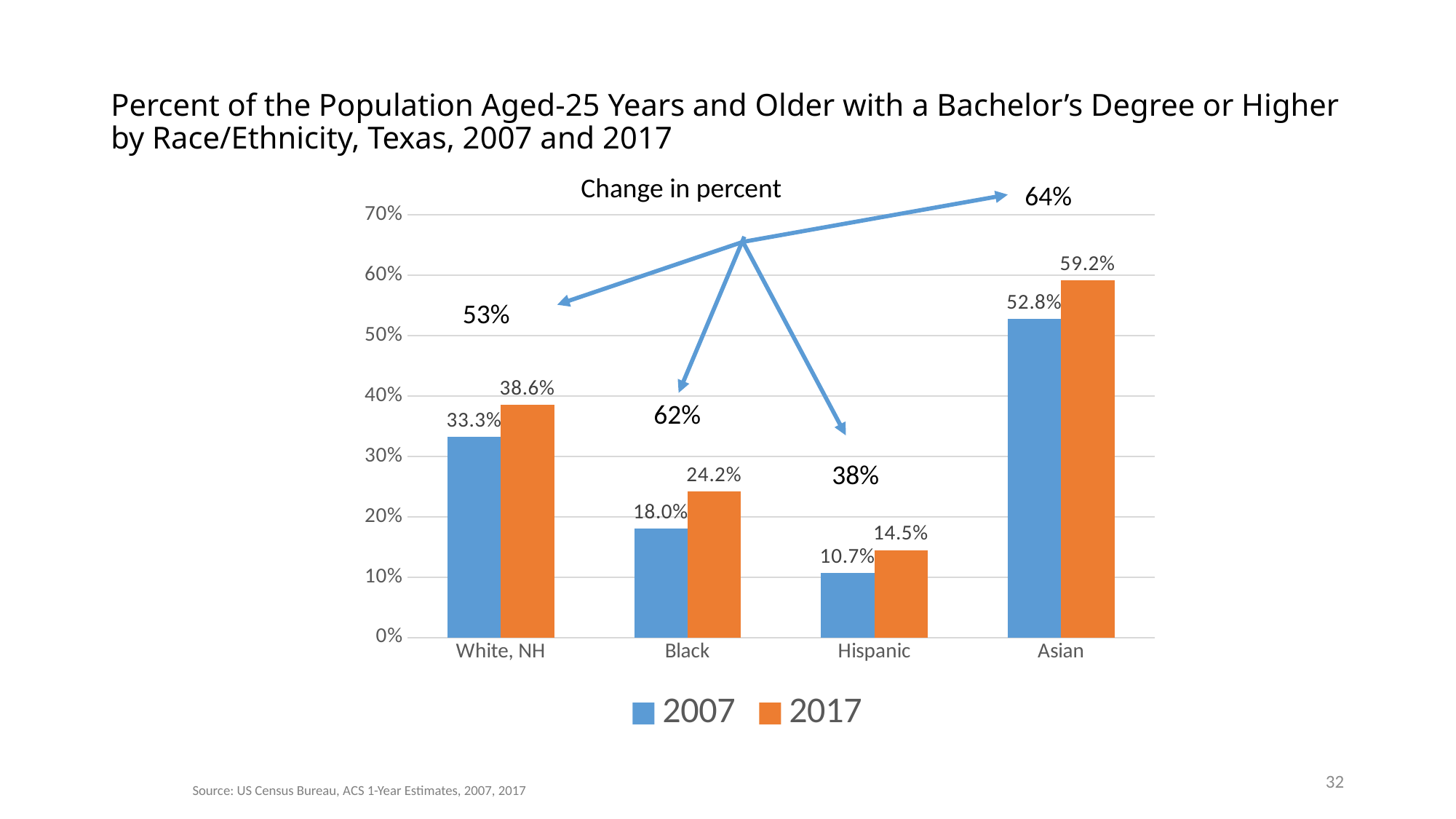
Is the 2007 value for Asian greater or less than 50%? greater What is the 2007 value for Hispanic? 10.7% What kind of chart is shown on the slide? Bar chart Which race/ethnicity group has the lowest 2007 value? Hispanic Which race/ethnicity group has the highest 2017 value? Asian What is the 2017 value for Black? 24.2% Which is larger, the 2007 value for Black or the 2017 value for Hispanic? 2007 value for Black What is the difference between the 2017 and 2007 values for White, NH? 5.3% How many series does the legend list? 2 How many race/ethnicity categories are shown on the x axis? 4 What is the 2017 value for Asian? 59.2% What change in percent is annotated for the Black group? 62%